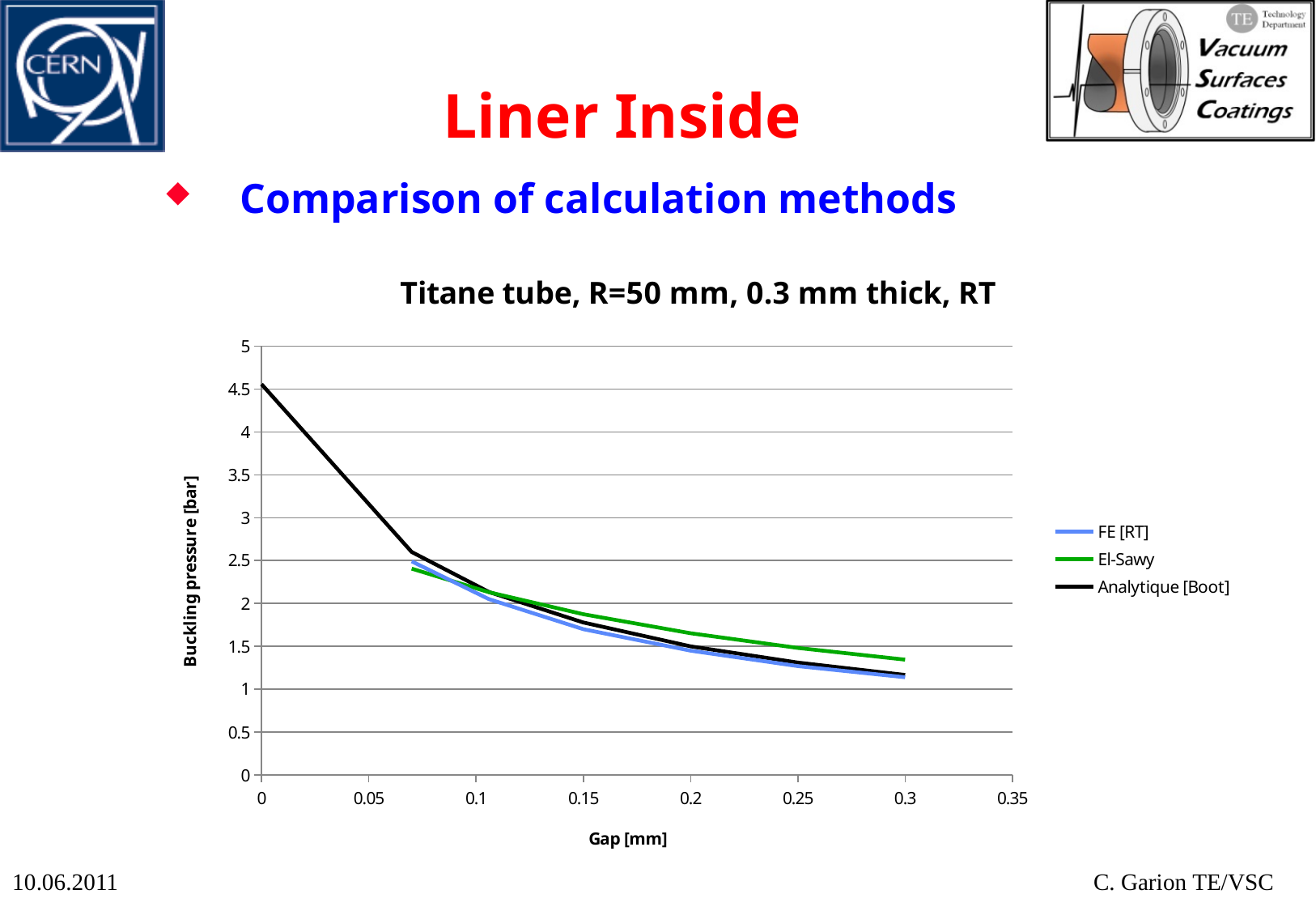
What is the title of the chart? Titane tube, R=50 mm, 0.3 mm thick, RT Is the value of Analytique [Boot] at gap 0 greater or less than 4? greater At gap 0.25, which is larger: El-Sawy or FE [RT]? El-Sawy Is the value of El-Sawy at gap 0.3 greater or less than 1.5? less Does the buckling pressure rise or fall as the gap increases? fall Is the value of Analytique [Boot] at gap 0.05 greater or less than 2.5? greater Which series is drawn in green? El-Sawy What kind of chart is shown on the slide? line chart At gap 0.3, which series has the highest buckling pressure? El-Sawy How many series does the legend list? 3